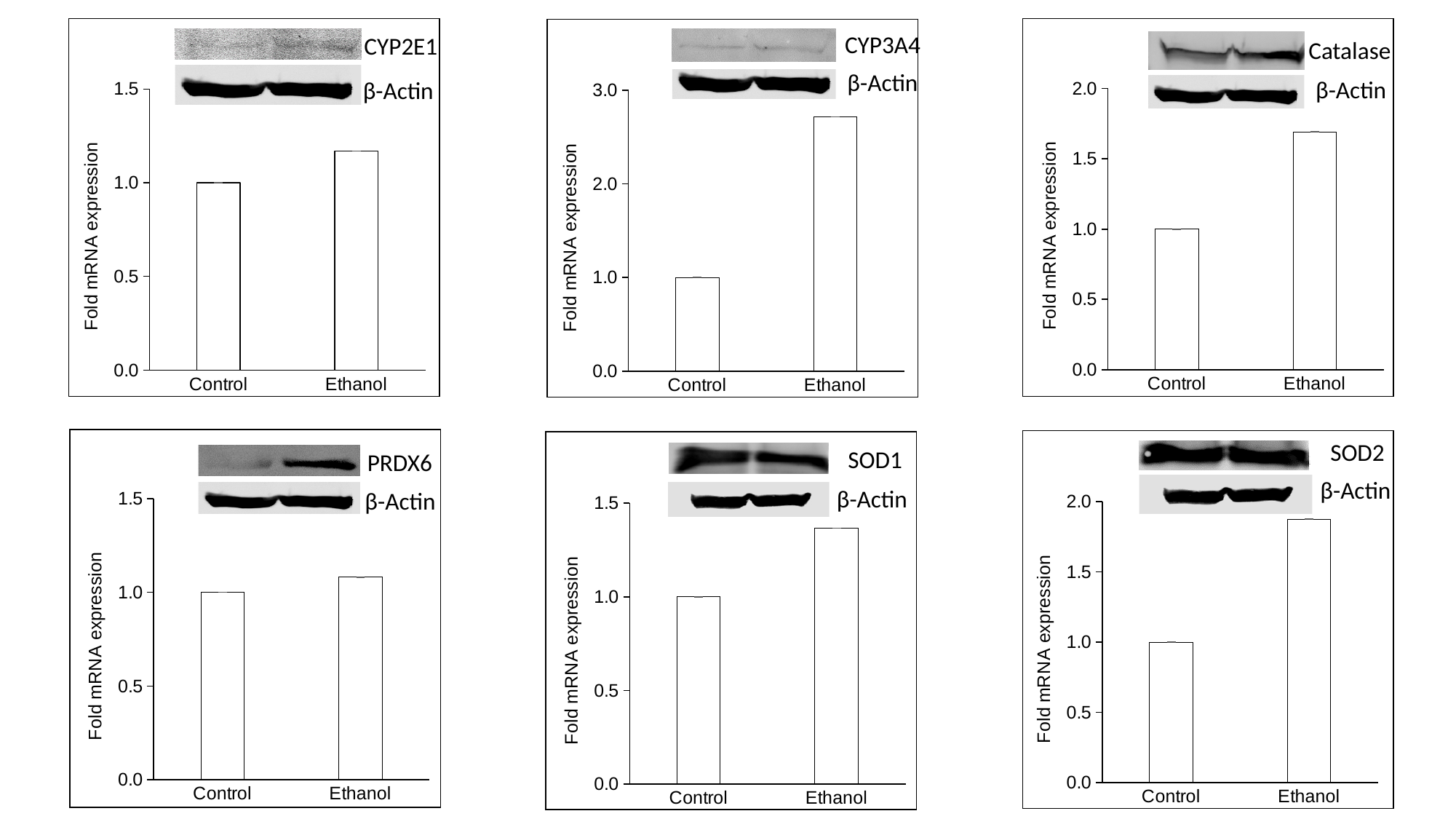
In the CYP3A4 chart (top middle), is the value for Ethanol greater or less than 2.0? greater How many categories are shown on the x axis of the CYP2E1 chart (top left)? 2 In the Catalase chart (top right), is the value for Ethanol greater or less than 1.5? greater In the SOD2 chart (bottom right), what is the fold mRNA expression for Control? 1.0 In the PRDX6 chart (bottom left), which bar is higher, Control or Ethanol? Ethanol In the CYP3A4 chart (top middle), which category has the highest fold mRNA expression? Ethanol In the SOD1 chart (bottom middle), is the value for Ethanol greater or less than 1.5? less In the CYP2E1 chart (top left), what is the fold mRNA expression for Control? 1.0 What is the y-axis label of the PRDX6 chart (bottom left)? Fold mRNA expression In the SOD1 chart (bottom middle), do the values rise or fall from Control to Ethanol? rise What kind of chart is the Catalase chart (top right)? bar chart